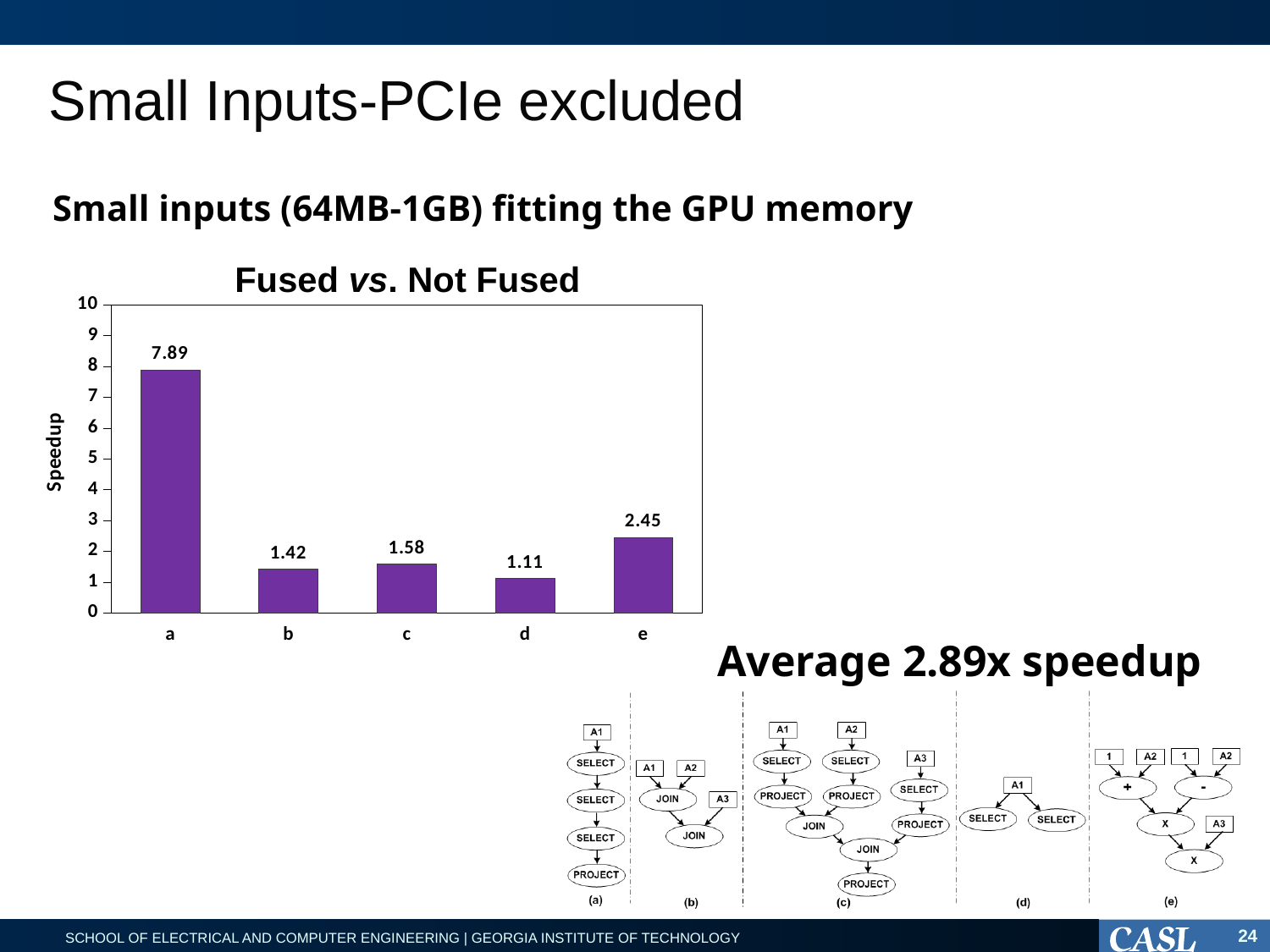
Which category has the lowest speedup? d What is the speedup value for category a? 7.89 How many categories are shown on the x axis? 5 What is the title of the chart? Fused vs. Not Fused Which category has the highest speedup? a What is the difference between the speedup for a and the speedup for e? 5.44 Is the speedup for e greater or less than 2? greater What is the speedup value for category e? 2.45 What is the label of the y axis? Speedup What kind of chart is shown? bar chart What is the speedup value for category d? 1.11 Which has a larger speedup, b or c? c